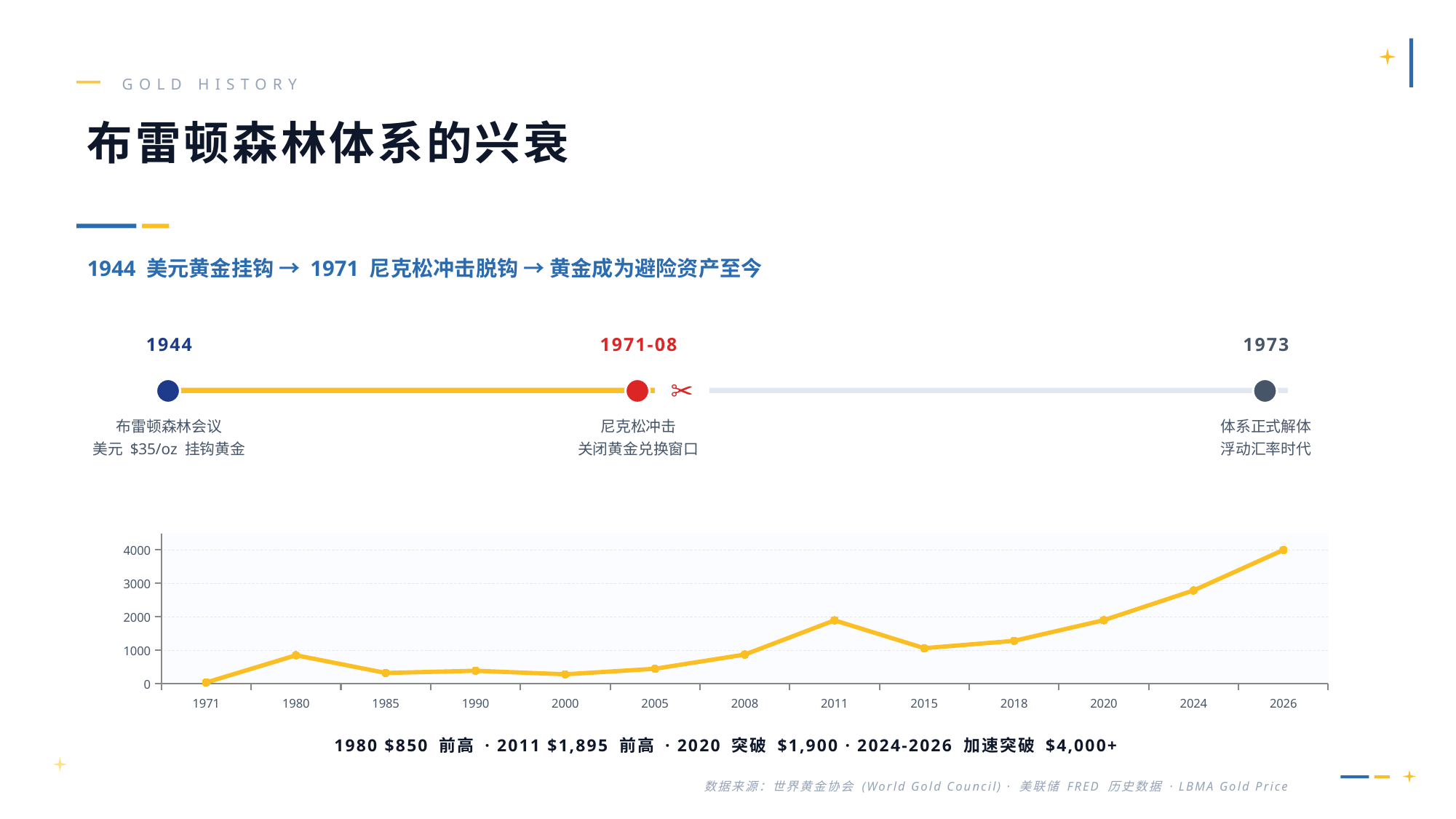
Is the value for 2000 on the line chart greater or less than 1000? less On the line chart, which is larger, the value for 1980 or the value for 1985? 1980 Does the line chart rise or fall from 2015 to 2026? rise Is the value for 2011 on the line chart greater or less than 1000? greater What kind of chart is shown at the bottom of the slide? line chart How many years are labelled on the x axis of the line chart? 13 Which year on the line chart has the lowest value? 1971 On the line chart, which is larger, the value for 2011 or the value for 2015? 2011 What colour is the line plotted on the chart? yellow Is the value for 1980 on the line chart greater or less than 1000? less Which year on the line chart has the highest value? 2026